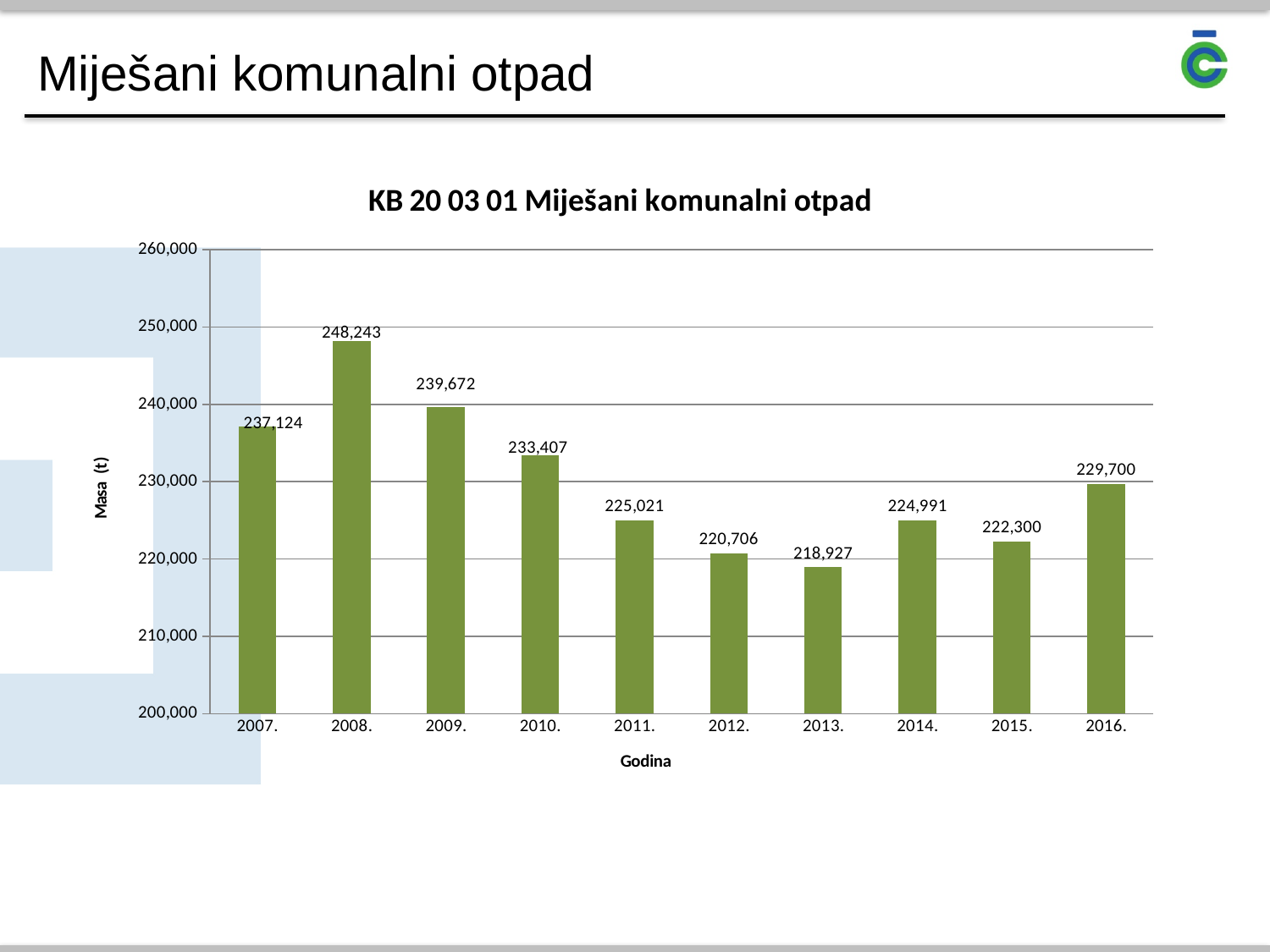
Which year has the highest value? 2008. What is the value for 2008. in the chart? 248,243 What is the difference between the values for 2016. and 2015.? 7,400 How many years are shown on the x axis? 10 What is the value for 2013. in the chart? 218,927 What is the value for 2016. in the chart? 229,700 Is the value for 2010. greater or less than 230,000? greater What is the difference between the values for 2008. and 2007.? 11,119 What kind of chart is shown on the slide? bar chart Which is larger, the value for 2009. or the value for 2010.? 2009. Do the values rise or fall from 2008. to 2013.? fall Which year has the lowest value? 2013.